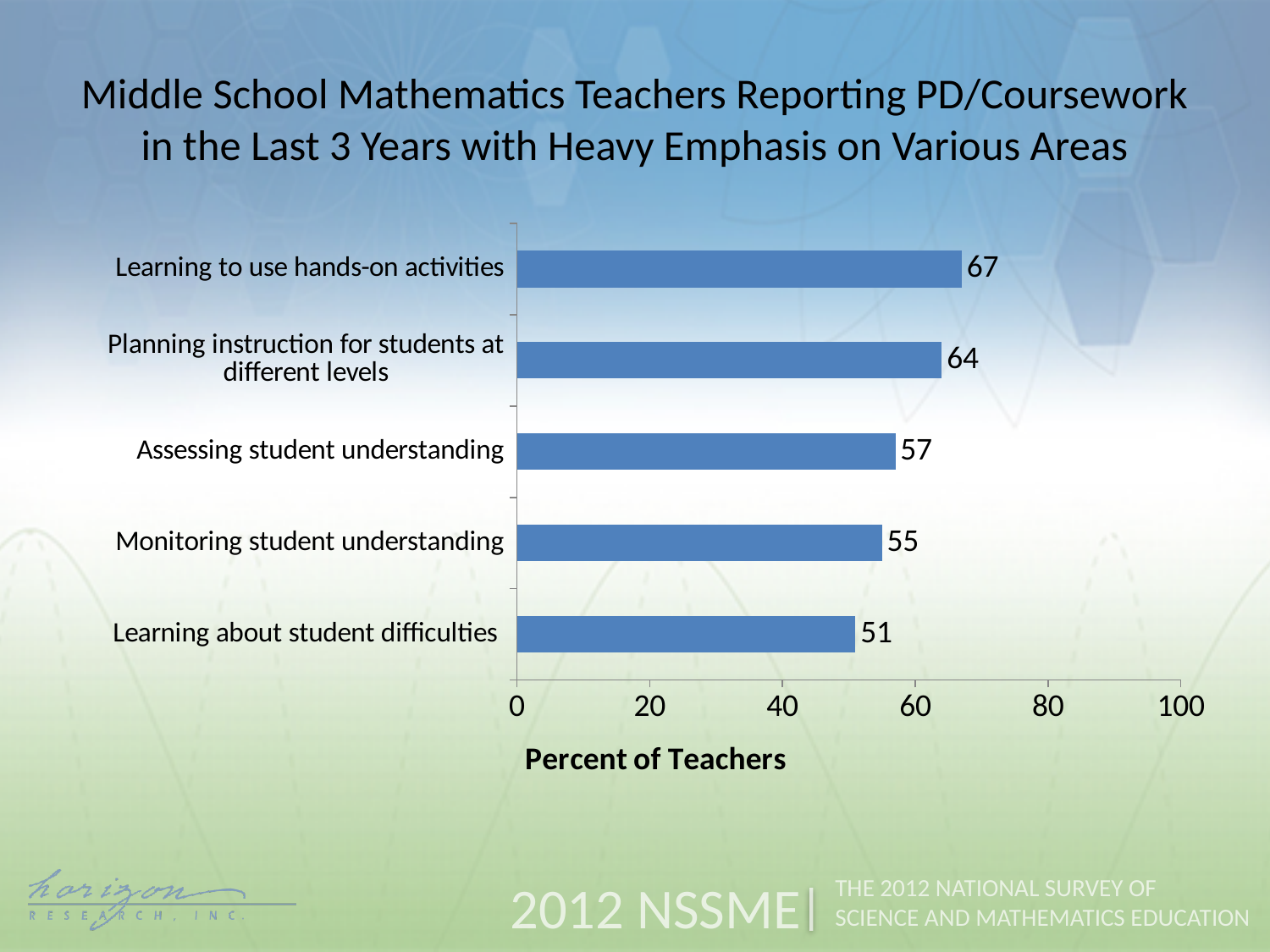
What is the difference between assessing student understanding and monitoring student understanding? 2 What is the value for learning about student difficulties? 51 What is the value for planning instruction for students at different levels? 64 Which area has the lowest percent of teachers? Learning about student difficulties What percent of teachers reported heavy emphasis on learning to use hands-on activities? 67 What kind of chart is shown on the slide? Bar chart Which area has the highest percent of teachers? Learning to use hands-on activities How many areas are shown in the chart? 5 What is the label of the horizontal axis? Percent of Teachers What is the difference between the values for learning to use hands-on activities and learning about student difficulties? 16 Which is larger: the value for planning instruction for students at different levels or for monitoring student understanding? Planning instruction for students at different levels What is the value for assessing student understanding? 57